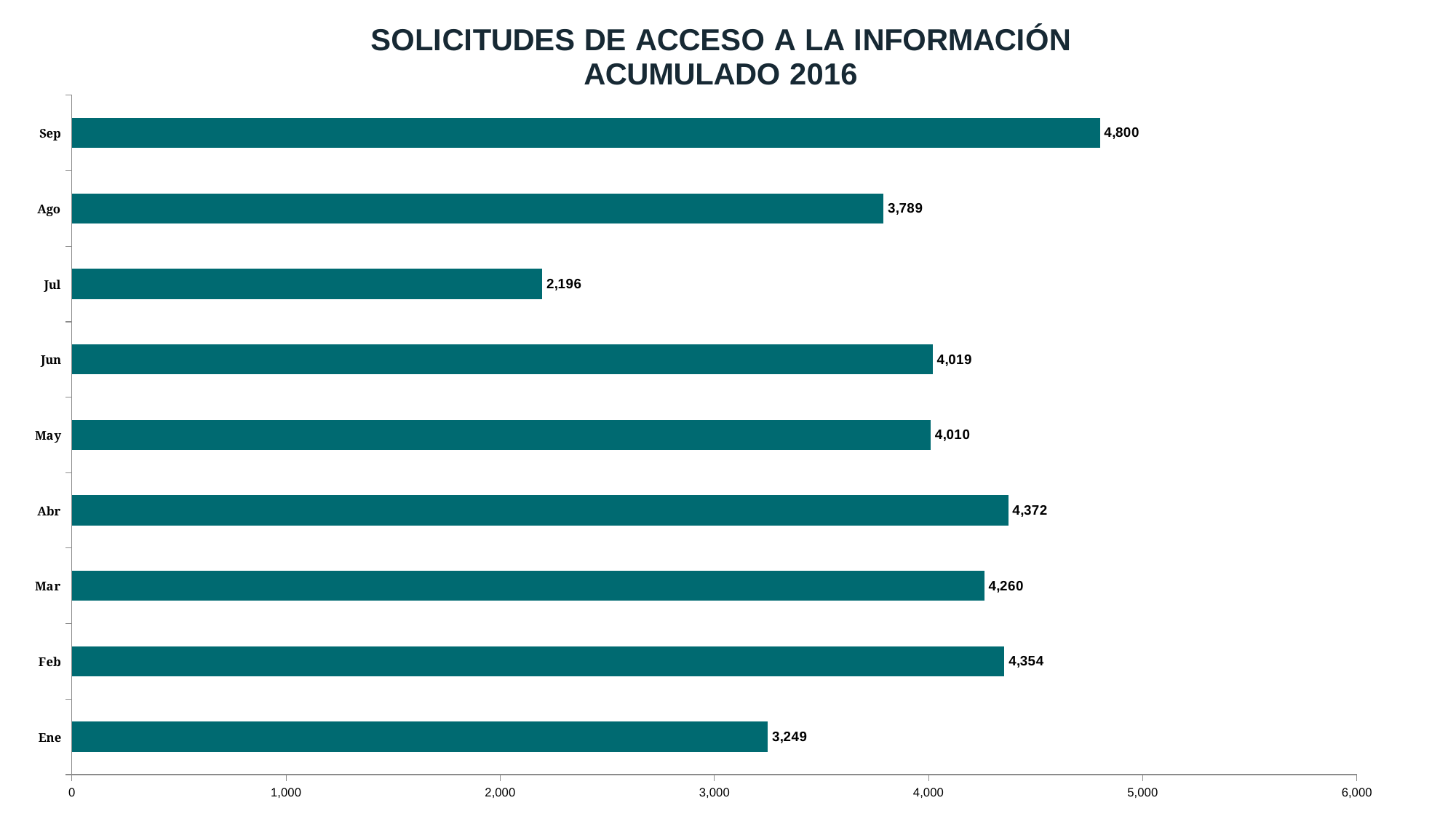
Which is larger, the value for Feb or the value for Ene? Feb Is the value for Ago greater or less than 4,000? less What is the difference between the values for Sep and Ago? 1,011 What is the value for Ene? 3,249 What is the value for Jul? 2,196 Which month has the highest value? Sep Which month has the lowest value? Jul What is the title of the chart? SOLICITUDES DE ACCESO A LA INFORMACIÓN ACUMULADO 2016 What is the difference between the values for Abr and Mar? 112 How many months are shown in the chart? 9 What kind of chart is shown on the slide? bar chart What is the value for Sep? 4,800